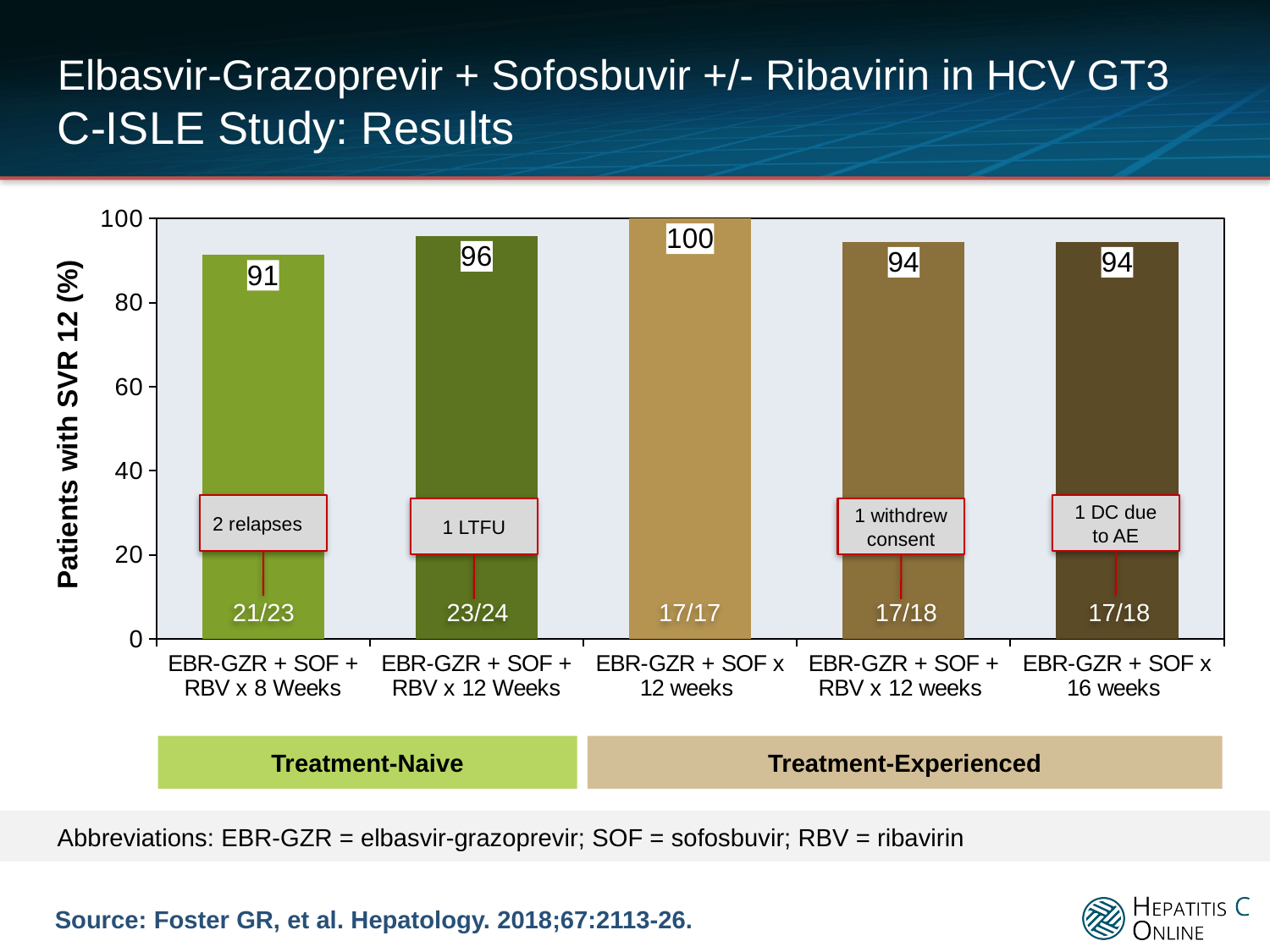
What kind of chart is shown on the slide? Bar chart What is the SVR 12 rate for EBR-GZR + SOF x 12 weeks? 100 Which treatment arm has the lowest SVR 12 rate? EBR-GZR + SOF + RBV x 8 Weeks Which has a higher SVR 12 rate: EBR-GZR + SOF + RBV x 8 Weeks or EBR-GZR + SOF + RBV x 12 Weeks? EBR-GZR + SOF + RBV x 12 Weeks Which treatment arm has the highest SVR 12 rate? EBR-GZR + SOF x 12 weeks What reason is given for the non-response in the EBR-GZR + SOF x 16 weeks arm? 1 DC due to AE What is the label on the y axis of the chart? Patients with SVR 12 (%) How many treatment arms are shown in the chart? 5 What is the difference in SVR 12 rate between EBR-GZR + SOF x 12 weeks and EBR-GZR + SOF + RBV x 8 Weeks? 9 What fraction of patients achieved SVR 12 with EBR-GZR + SOF + RBV x 12 Weeks? 23/24 What is the SVR 12 rate for EBR-GZR + SOF + RBV x 8 Weeks? 91 What is the SVR 12 rate for EBR-GZR + SOF x 16 weeks? 94